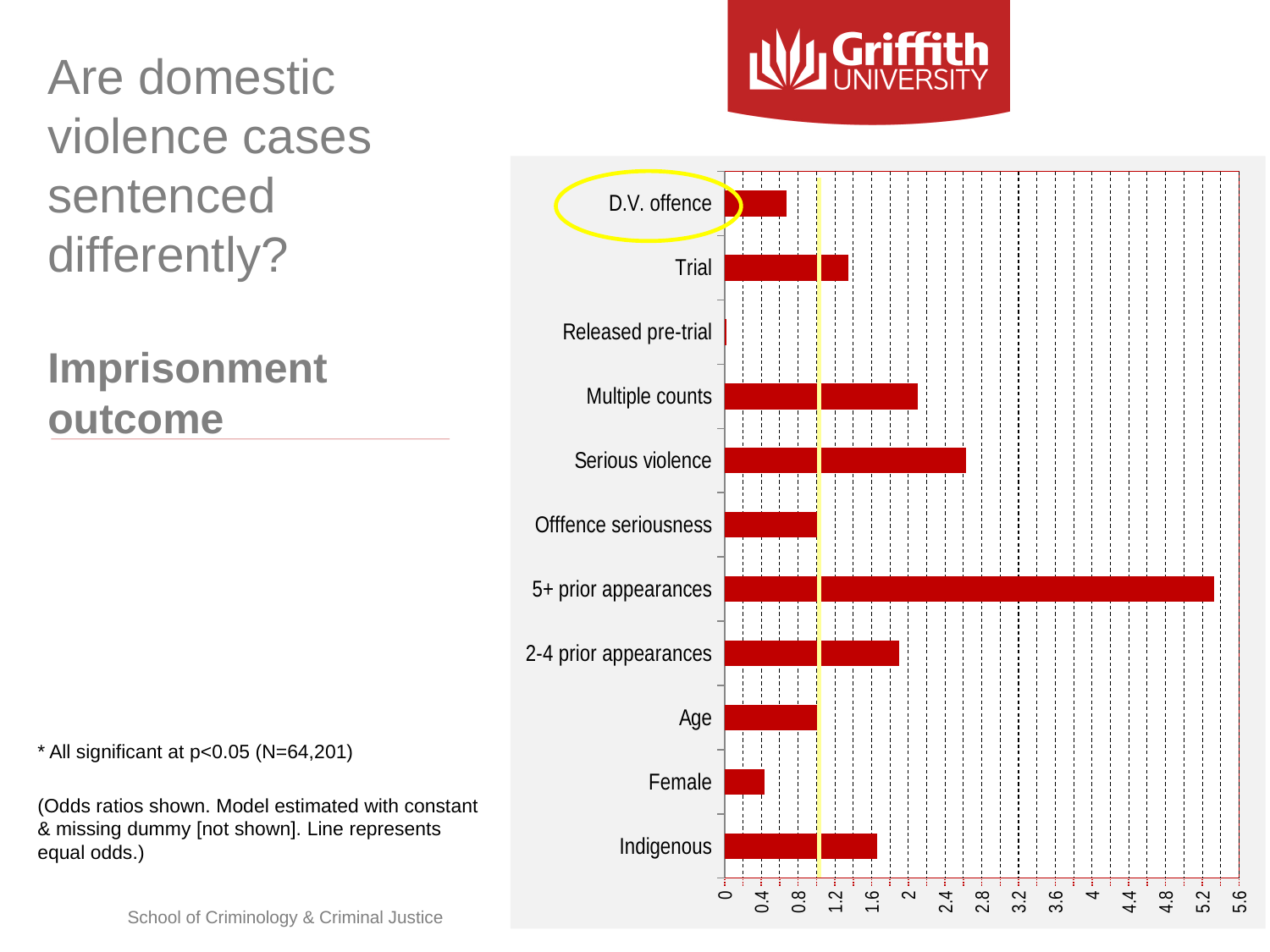
Which has the larger value, Serious violence or Multiple counts? Serious violence Is the value for Female greater or less than 0.8? less Which category has the lowest odds ratio on the chart? Released pre-trial Is the value for Indigenous greater or less than 1.2? greater Is the value for Serious violence greater or less than 2.4? greater What kind of chart is shown on the slide? Bar chart How many categories are plotted on the chart? 11 Which category has the highest odds ratio on the chart? 5+ prior appearances Which has the larger value, D.V. offence or Female? D.V. offence According to the slide's note, what does the vertical line on the chart represent? Equal odds